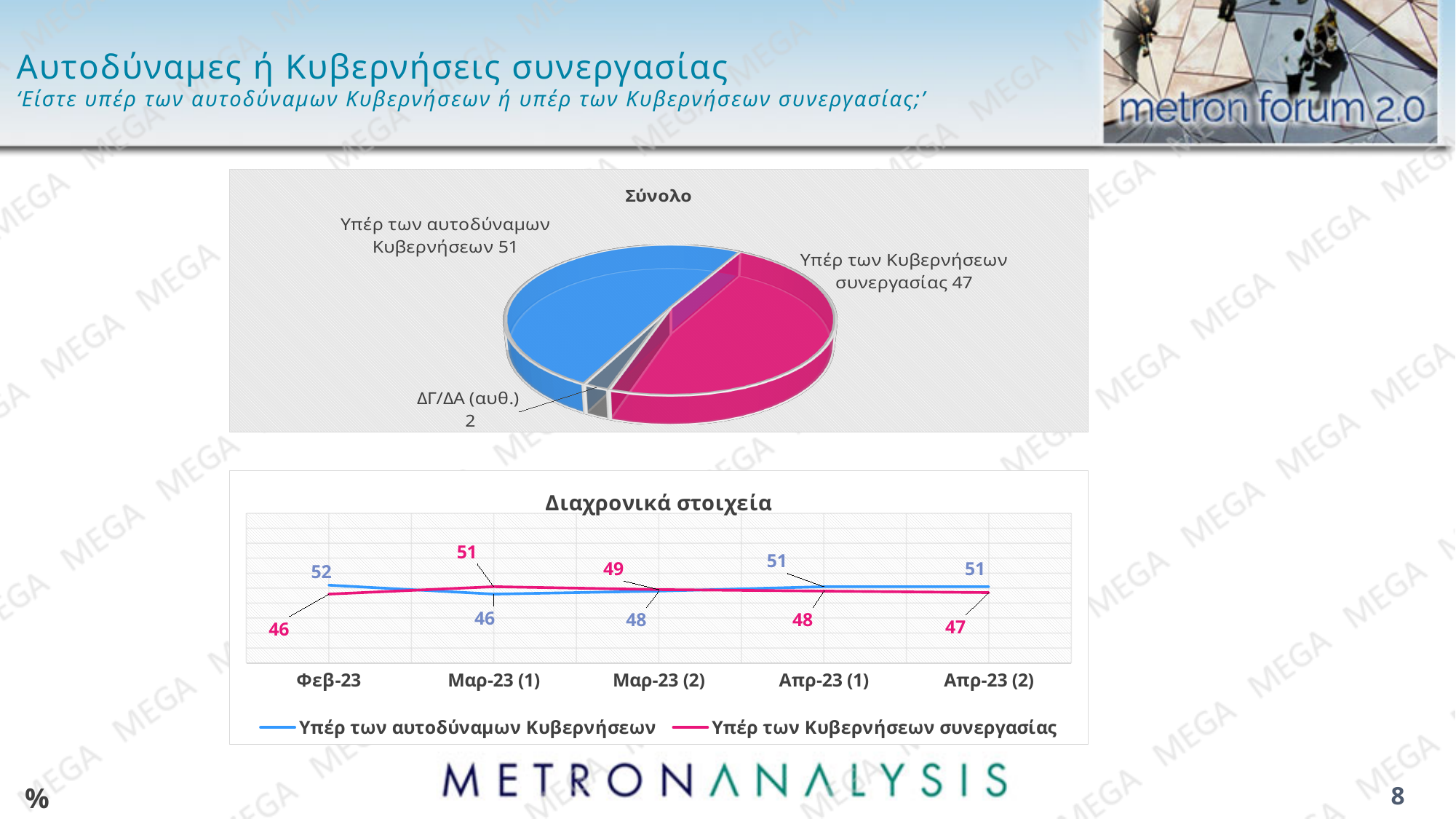
In the pie chart titled 'Σύνολο', which category has the smallest slice? ΔΓ/ΔΑ (αυθ.) In the chart titled 'Διαχρονικά στοιχεία', which series has the higher value at Απρ-23 (2)? Υπέρ των αυτοδύναμων Κυβερνήσεων In the pie chart titled 'Σύνολο', what is the value for 'ΔΓ/ΔΑ (αυθ.)'? 2 In the chart titled 'Διαχρονικά στοιχεία', what is the value for 'Υπέρ των Κυβερνήσεων συνεργασίας' at Μαρ-23 (1)? 51 In the pie chart titled 'Σύνολο', what is the difference between 'Υπέρ των αυτοδύναμων Κυβερνήσεων' and 'Υπέρ των Κυβερνήσεων συνεργασίας'? 4 In the chart titled 'Διαχρονικά στοιχεία', what is the value for 'Υπέρ των αυτοδύναμων Κυβερνήσεων' at Φεβ-23? 52 What kind of chart is the chart titled 'Διαχρονικά στοιχεία'? Line chart In the pie chart titled 'Σύνολο', what is the value for 'Υπέρ των αυτοδύναμων Κυβερνήσεων'? 51 In the pie chart titled 'Σύνολο', how many slices are there? 3 In the chart titled 'Διαχρονικά στοιχεία', at which point does 'Υπέρ των αυτοδύναμων Κυβερνήσεων' reach its lowest value? Μαρ-23 (1) In the chart titled 'Διαχρονικά στοιχεία', what is the difference between the two series at Φεβ-23? 6 In the chart titled 'Διαχρονικά στοιχεία', how many series does the legend list? 2